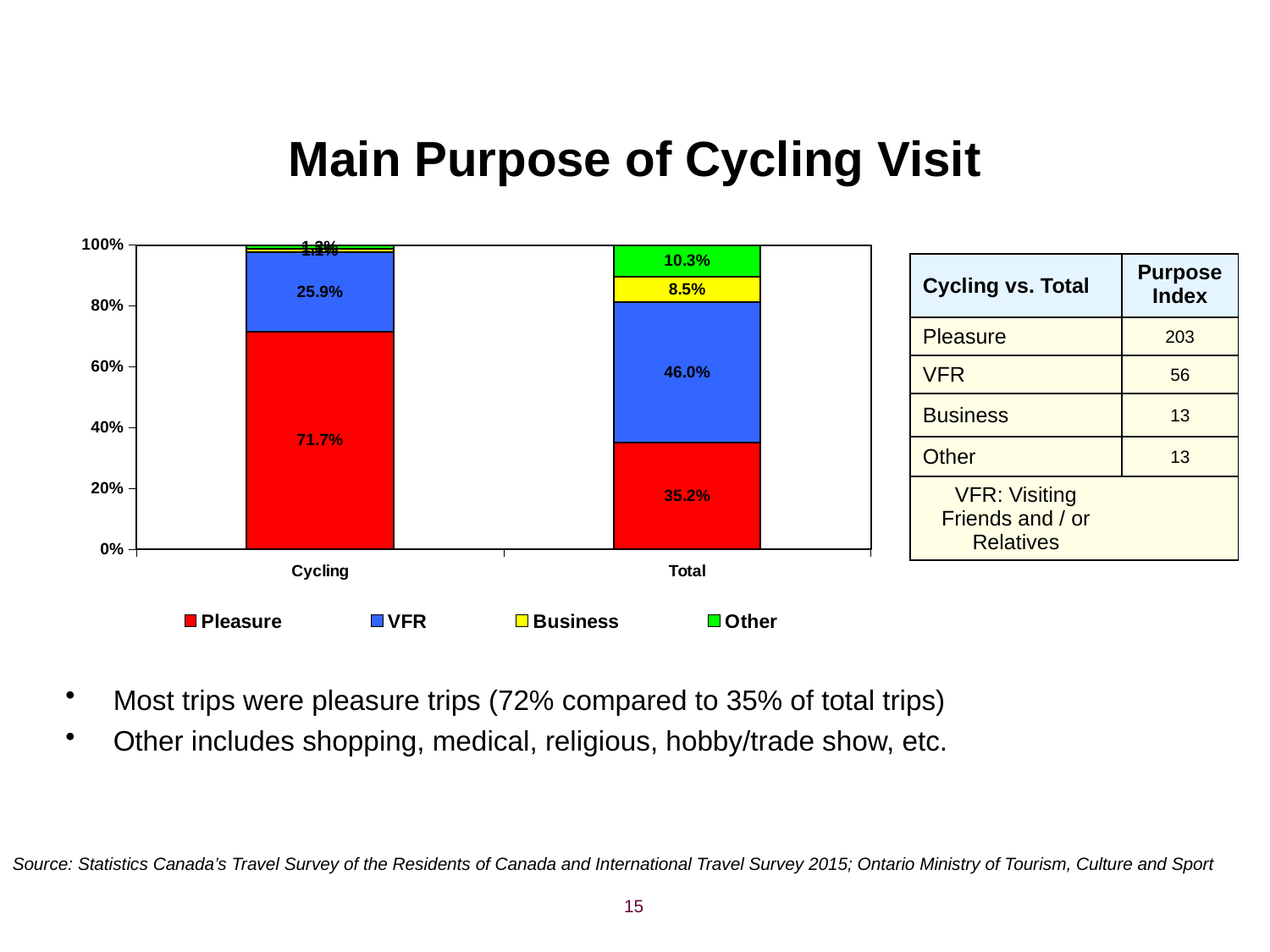
What percentage of total trips were for Pleasure? 35.2% How many percentage points higher is the Pleasure share for Cycling than for Total? 36.5 percentage points Which purpose has the largest share in the Total bar? VFR What percentage of total trips fall under Other? 10.3% Is the VFR share larger for Cycling or for Total? Total What percentage of cycling visits were for Pleasure? 71.7% How many series does the legend list? 4 How many bars are plotted in the chart? 2 What percentage of cycling visits were VFR? 25.9% What type of chart is shown on the slide? Stacked bar chart Which purpose has the smallest share in the Total bar? Business What percentage of total trips were for Business? 8.5%